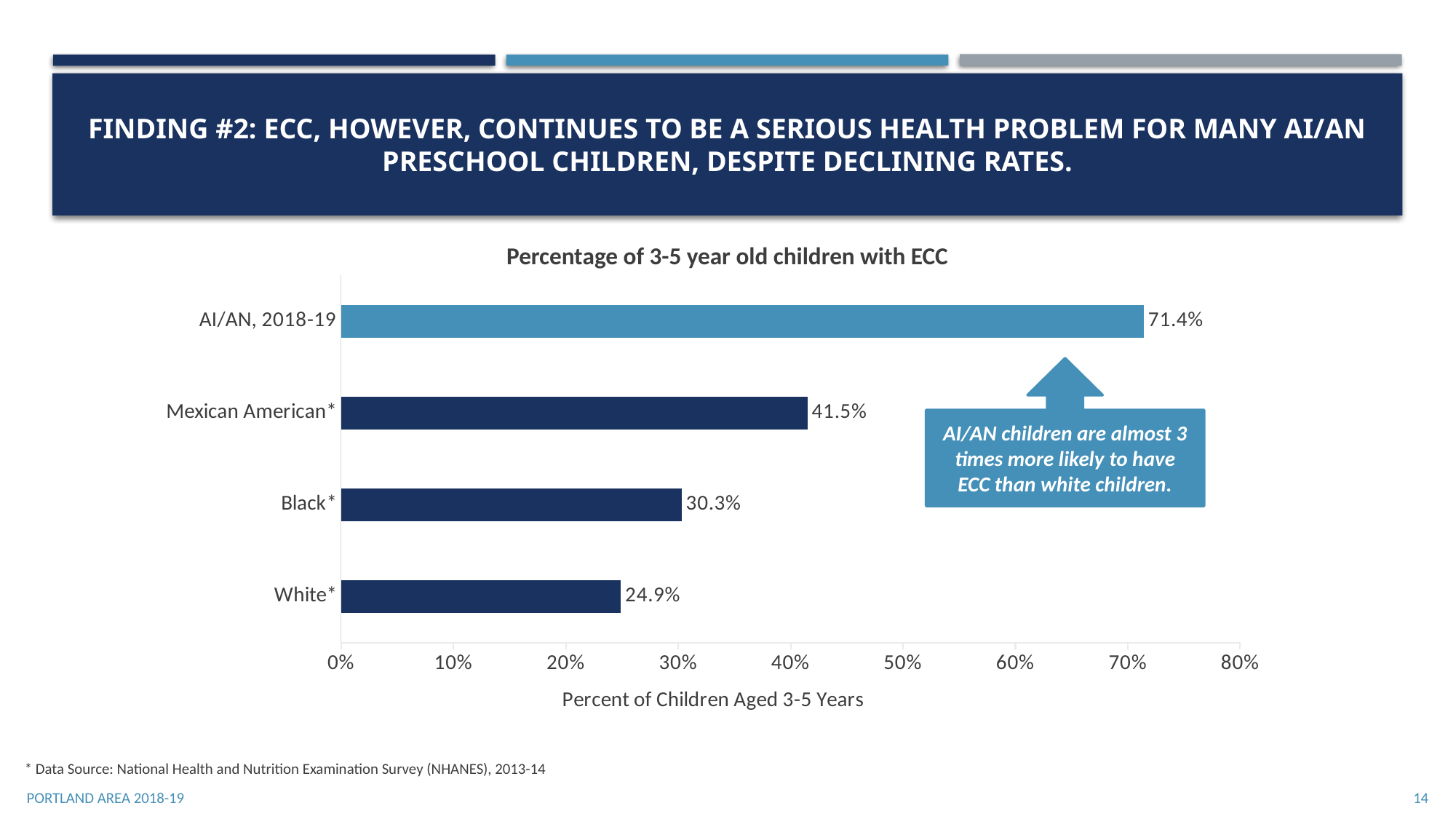
How many categories are shown in the bar chart? 4 Which category has the lowest percentage of children with ECC? White* What type of chart is shown on the slide? Bar chart Which category has the highest percentage of children with ECC? AI/AN, 2018-19 What is the percentage of 3-5 year old children with ECC for White*? 24.9% What is the difference in percentage points between Mexican American* and Black*? 11.2 What is the percentage of 3-5 year old children with ECC for AI/AN, 2018-19? 71.4% Which is larger, the value for Black* or the value for White*? Black* What is the percentage of 3-5 year old children with ECC for Mexican American*? 41.5% What is the percentage of 3-5 year old children with ECC for Black*? 30.3% What is the title of the chart? Percentage of 3-5 year old children with ECC What is the difference in percentage points between AI/AN, 2018-19 and White*? 46.5